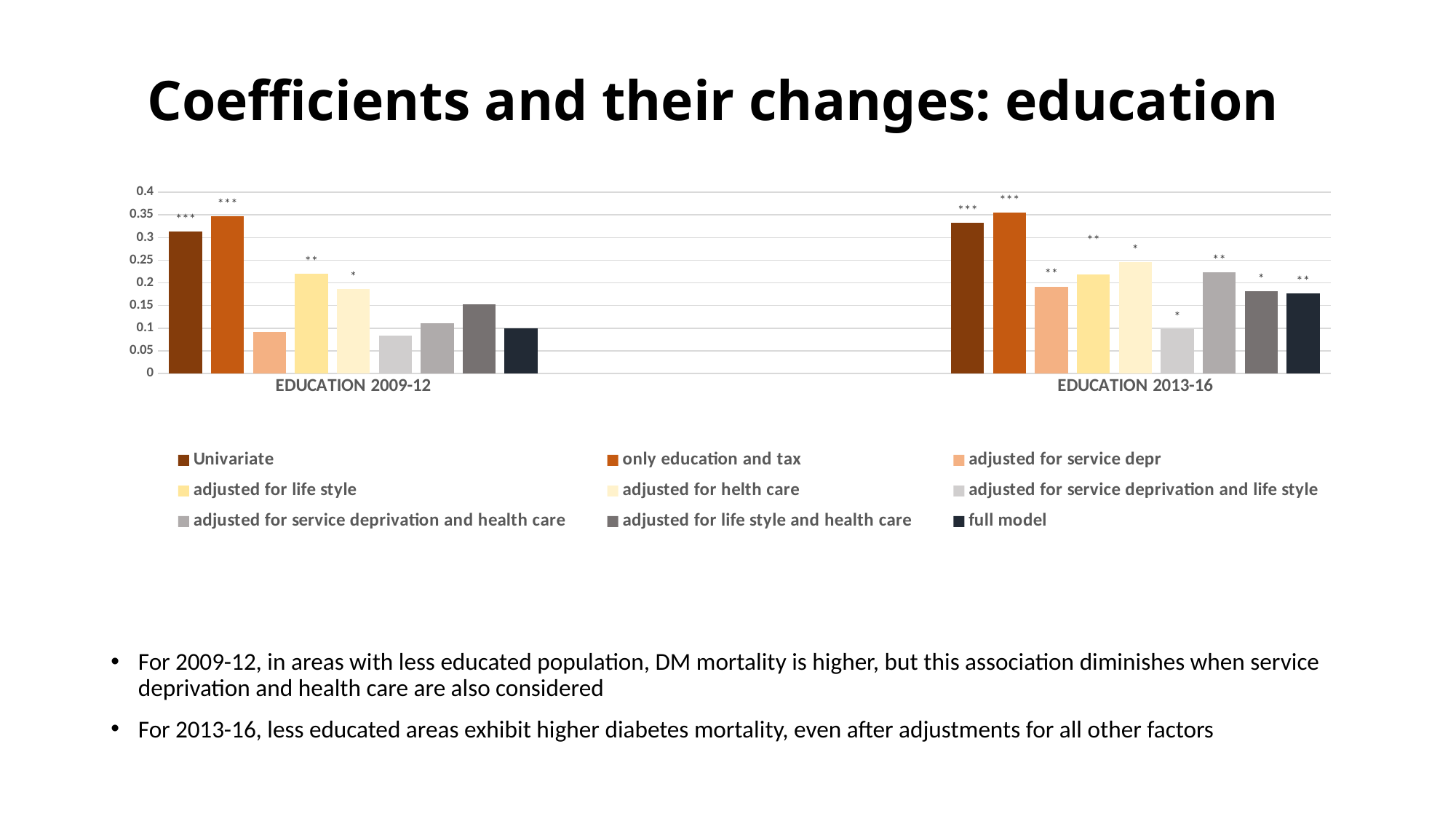
What is the title of the slide containing the chart? Coefficients and their changes: education How many categories are shown on the x axis of the chart? 2 Which series has the highest value for EDUCATION 2009-12? only education and tax What kind of chart is shown on the slide? bar chart Is the Univariate value for EDUCATION 2009-12 greater or less than 0.25? greater How many series does the chart's legend list? 9 Is the value for adjusted for helth care in EDUCATION 2013-16 greater or less than 0.2? greater For the series adjusted for service depr, which category has the larger value, EDUCATION 2009-12 or EDUCATION 2013-16? EDUCATION 2013-16 Is the value for the full model in EDUCATION 2009-12 greater or less than 0.15? less For the full model series, which category has the larger value, EDUCATION 2009-12 or EDUCATION 2013-16? EDUCATION 2013-16 Which series has the lowest value for EDUCATION 2013-16? adjusted for service deprivation and life style Which series has the highest value for EDUCATION 2013-16? only education and tax